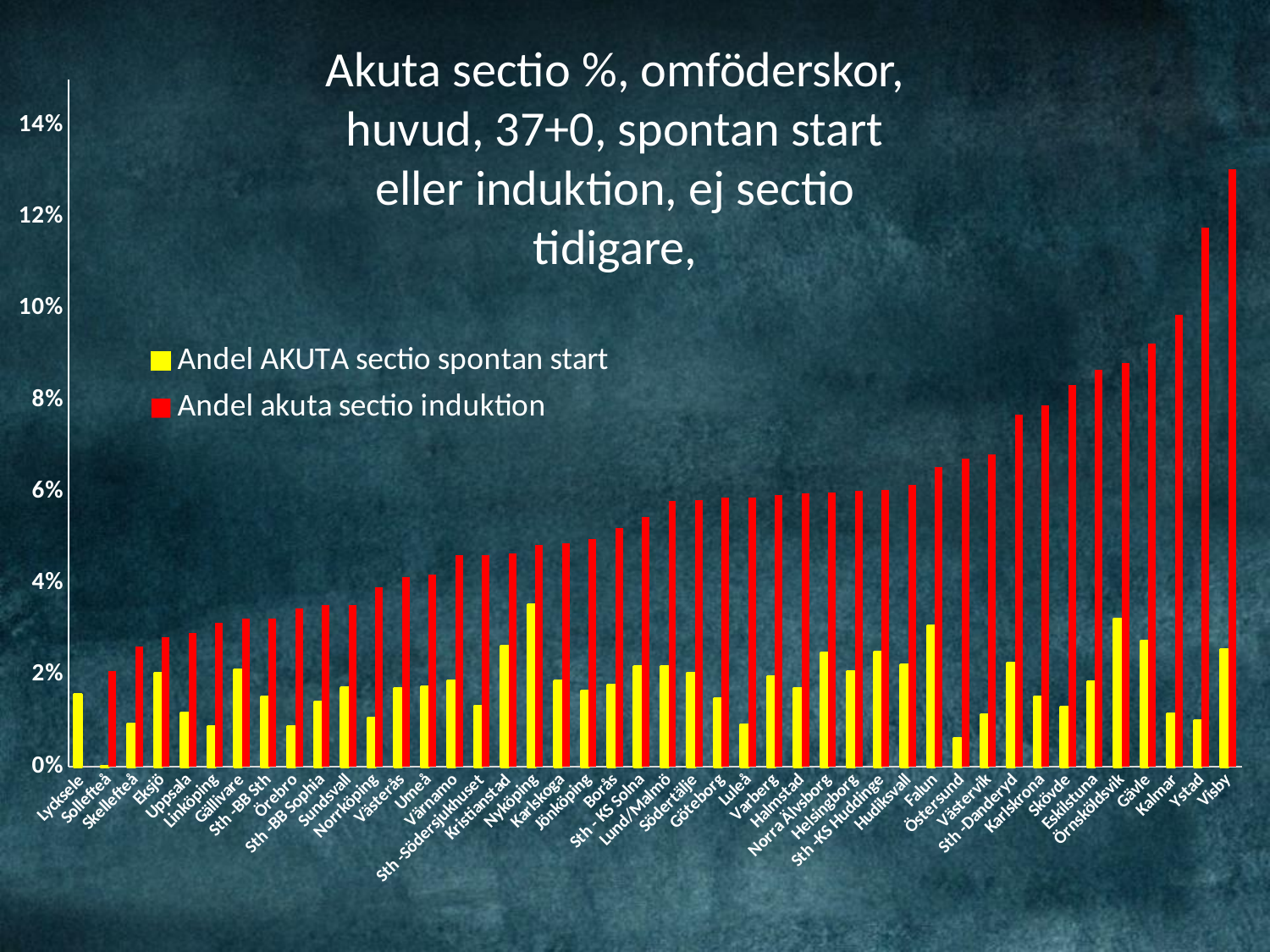
What colour represents 'Andel akuta sectio induktion' in the chart? red Which is larger, the 'Andel akuta sectio induktion' value for Visby or for Ystad? Visby How many series does the legend list? 2 Which is larger for Kalmar, 'Andel AKUTA sectio spontan start' or 'Andel akuta sectio induktion'? Andel akuta sectio induktion Which category has the highest value for 'Andel akuta sectio induktion'? Visby What kind of chart is shown on the slide? bar chart Which category has the highest value for 'Andel AKUTA sectio spontan start'? Nyköping Is the 'Andel akuta sectio induktion' value for Ystad greater or less than 10%? greater Do the 'Andel akuta sectio induktion' values generally rise or fall from left to right along the x axis? rise Is the 'Andel AKUTA sectio spontan start' value for Nyköping greater or less than 2%? greater Is the 'Andel akuta sectio induktion' value for Sollefteå greater or less than 4%? less